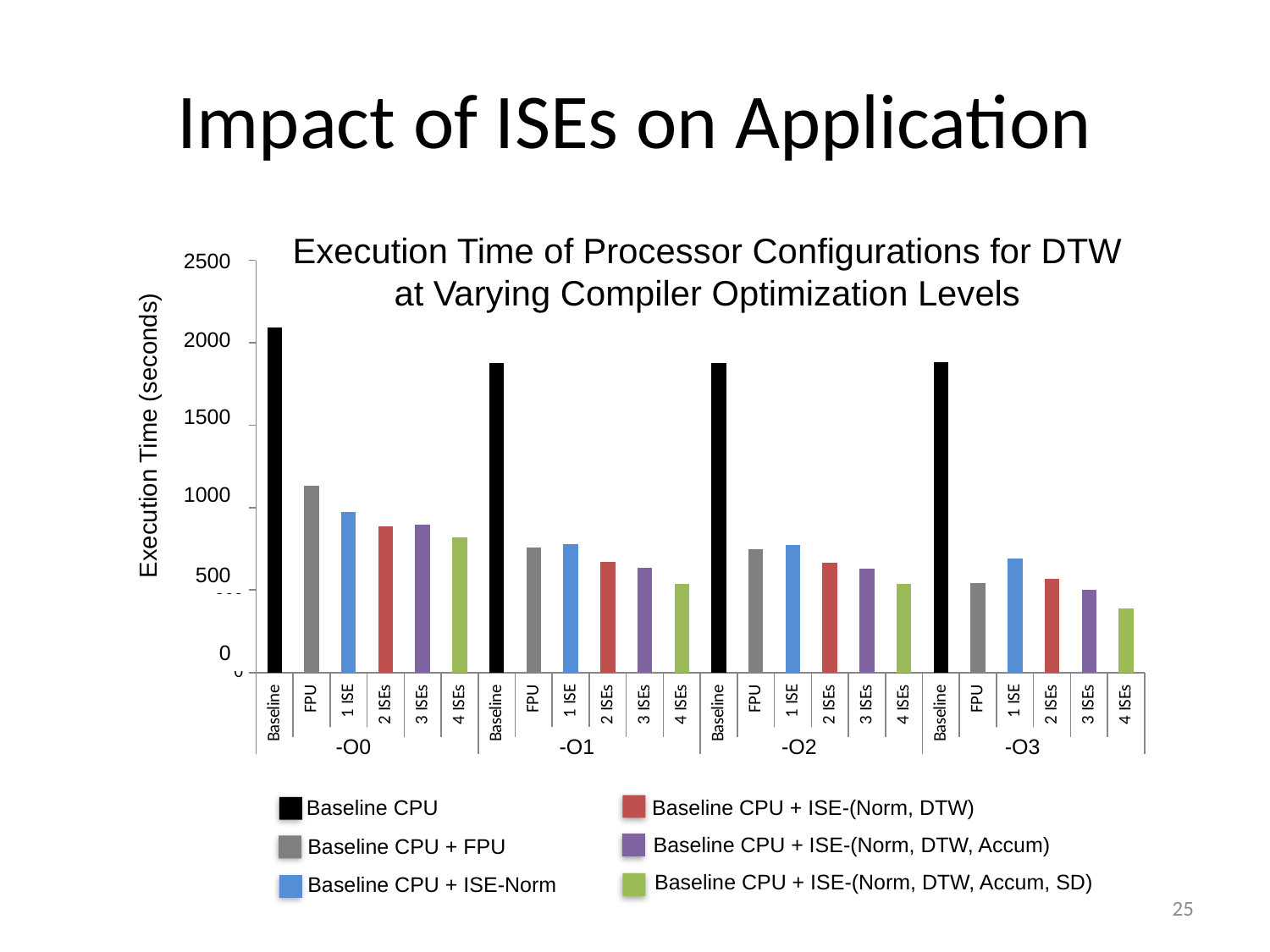
Is the execution time for FPU at -O0 greater or less than 1000 seconds? greater Which is larger, the execution time for FPU at -O0 or FPU at -O3? FPU at -O0 Which bar has the highest execution time in the chart? Baseline at -O0 How many series does the legend list? 6 Which bar has the lowest execution time in the chart? 4 ISEs at -O3 Within the -O3 group, does execution time rise or fall from Baseline to 4 ISEs? fall How many bars are plotted within each optimization level group? 6 What is the label of the y axis? Execution Time (seconds) Is the execution time for 4 ISEs at -O3 greater or less than 500 seconds? less How many compiler optimization levels are shown along the x axis? 4 What kind of chart is shown on the slide? bar chart Is the execution time for Baseline at -O0 greater or less than 2000 seconds? greater